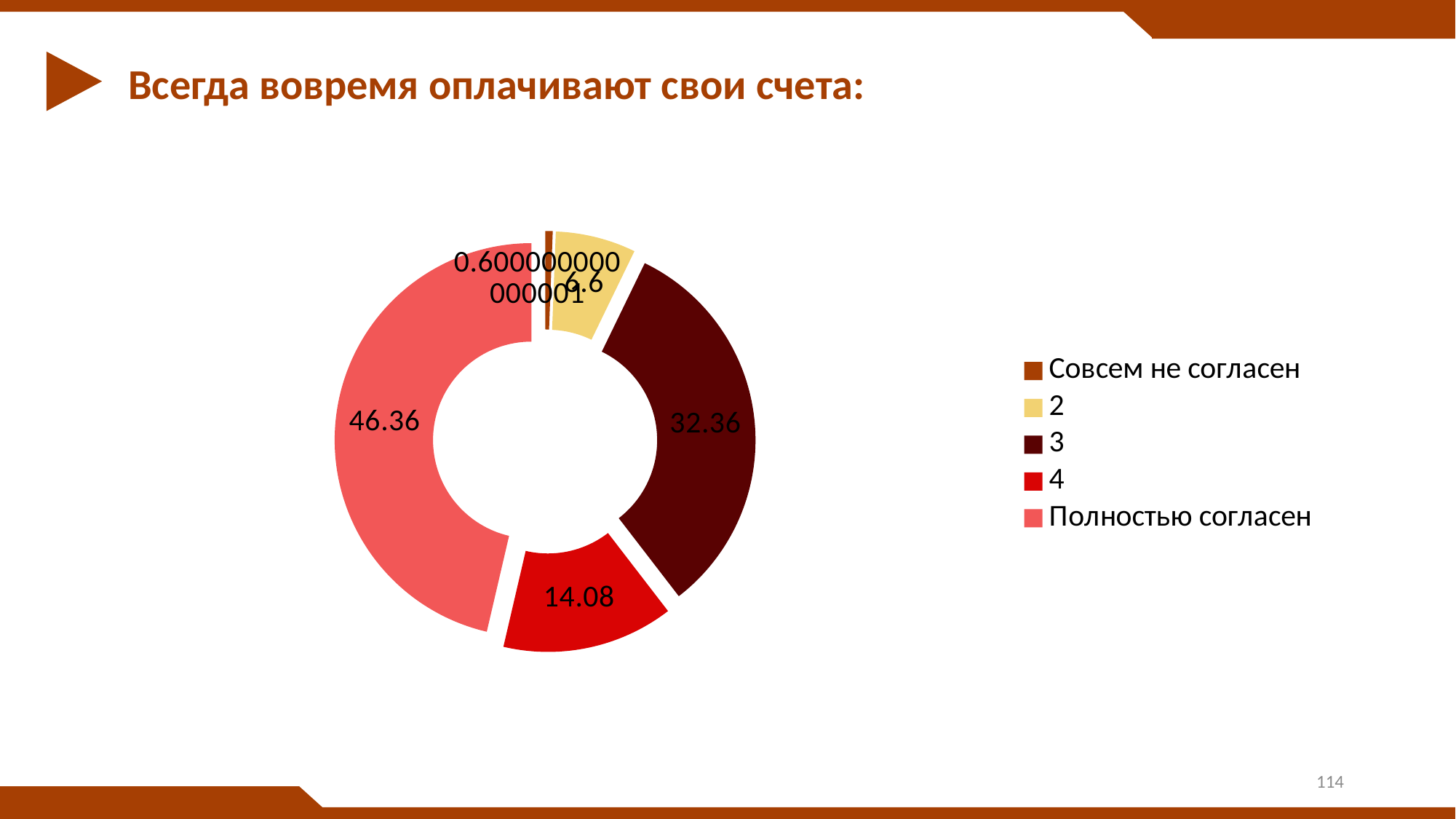
What is the value for "Полностью согласен"? 46.36 What is the difference between the values for "Полностью согласен" and "3"? 14 What is the value for category "2"? 6.6 Which category has the largest slice? Полностью согласен What is the title of the slide above the chart? Всегда вовремя оплачивают свои счета: What is the value for category "3"? 32.36 What is the difference between the values for "3" and "4"? 18.28 Which category has the smallest slice? Совсем не согласен Which is larger, the value for "4" or the value for "2"? 4 What is the value for category "4"? 14.08 What kind of chart is shown on the slide? doughnut chart How many categories does the legend list? 5